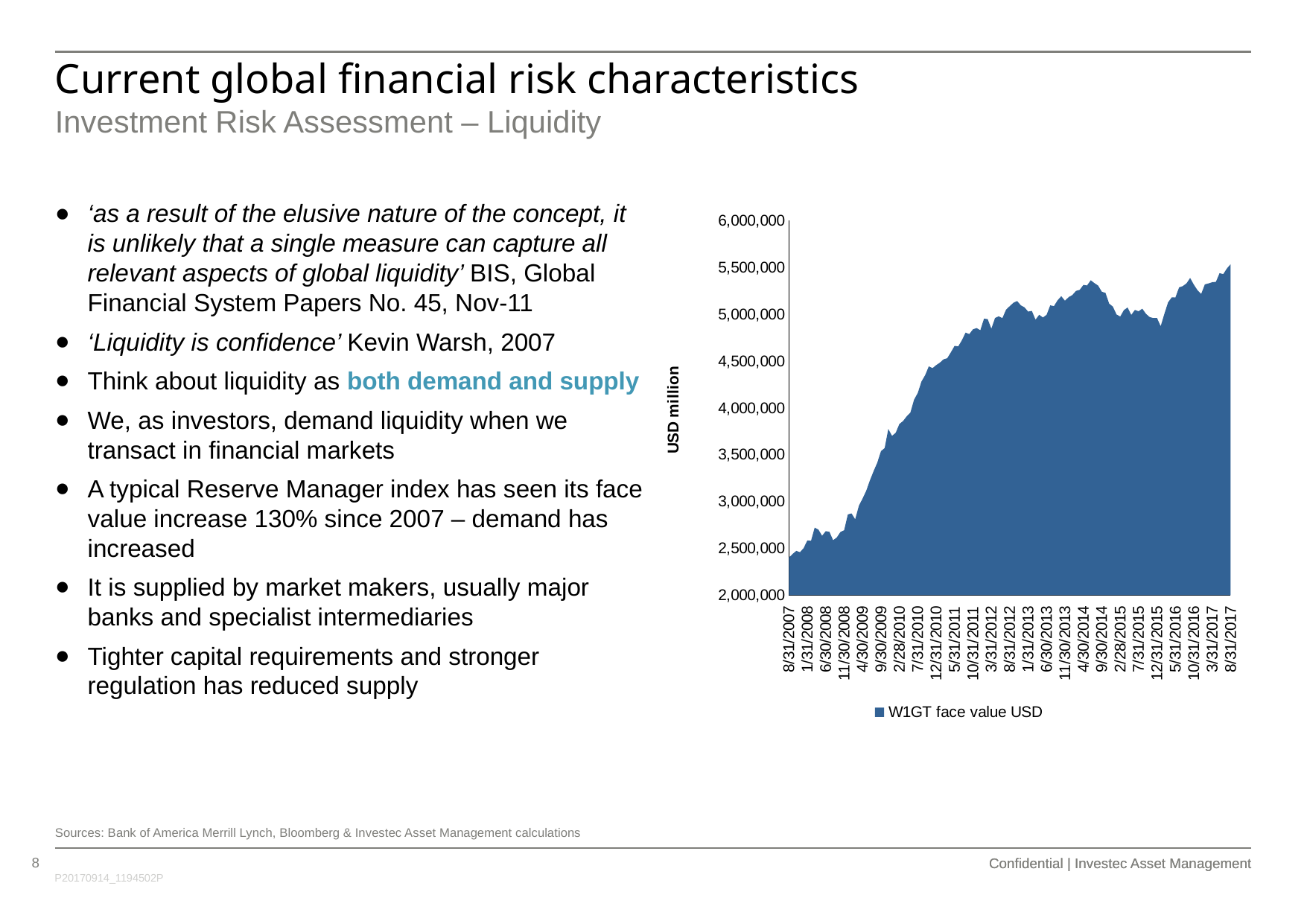
Is the W1GT face value at 9/30/2009 greater or less than 3,000,000? greater At which date on the x axis is the W1GT face value at its lowest? 8/31/2007 Which is larger, the W1GT face value at 8/31/2007 or at 8/31/2017? 8/31/2017 Is the W1GT face value at 12/31/2010 greater or less than 4,000,000? greater Does the W1GT face value generally rise or fall from 8/31/2007 to 8/31/2017? Rise Is the W1GT face value at 3/31/2012 greater or less than 4,500,000? greater How many series does the chart legend list? 1 What kind of chart is shown on the slide? Area chart What is the name of the series shown in the chart legend? W1GT face value USD What is the label on the vertical axis of the chart? USD million